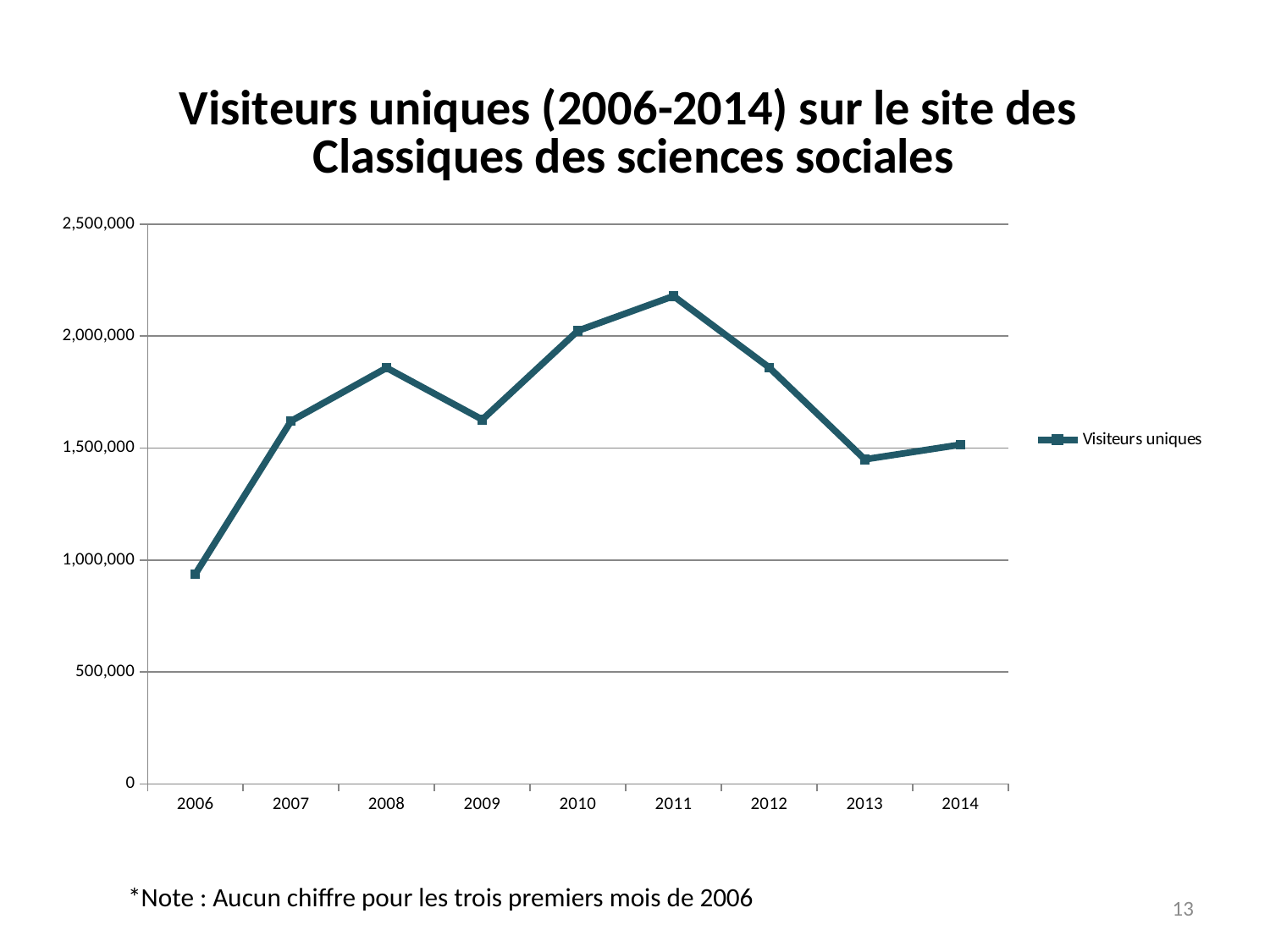
Is the value for 2012 greater or less than 2,000,000? less Is the value for 2006 greater or less than 1,000,000? less Which year has more unique visitors, 2011 or 2013? 2011 Is the value for 2013 greater or less than 1,500,000? less Which year has the highest number of unique visitors? 2011 How many years are plotted on the x axis? 9 Which year has the lowest number of unique visitors? 2006 Do the values rise or fall from 2011 to 2013? fall What kind of chart is shown on the slide? line chart What is the name of the series shown in the legend? Visiteurs uniques How many series does the legend list? 1